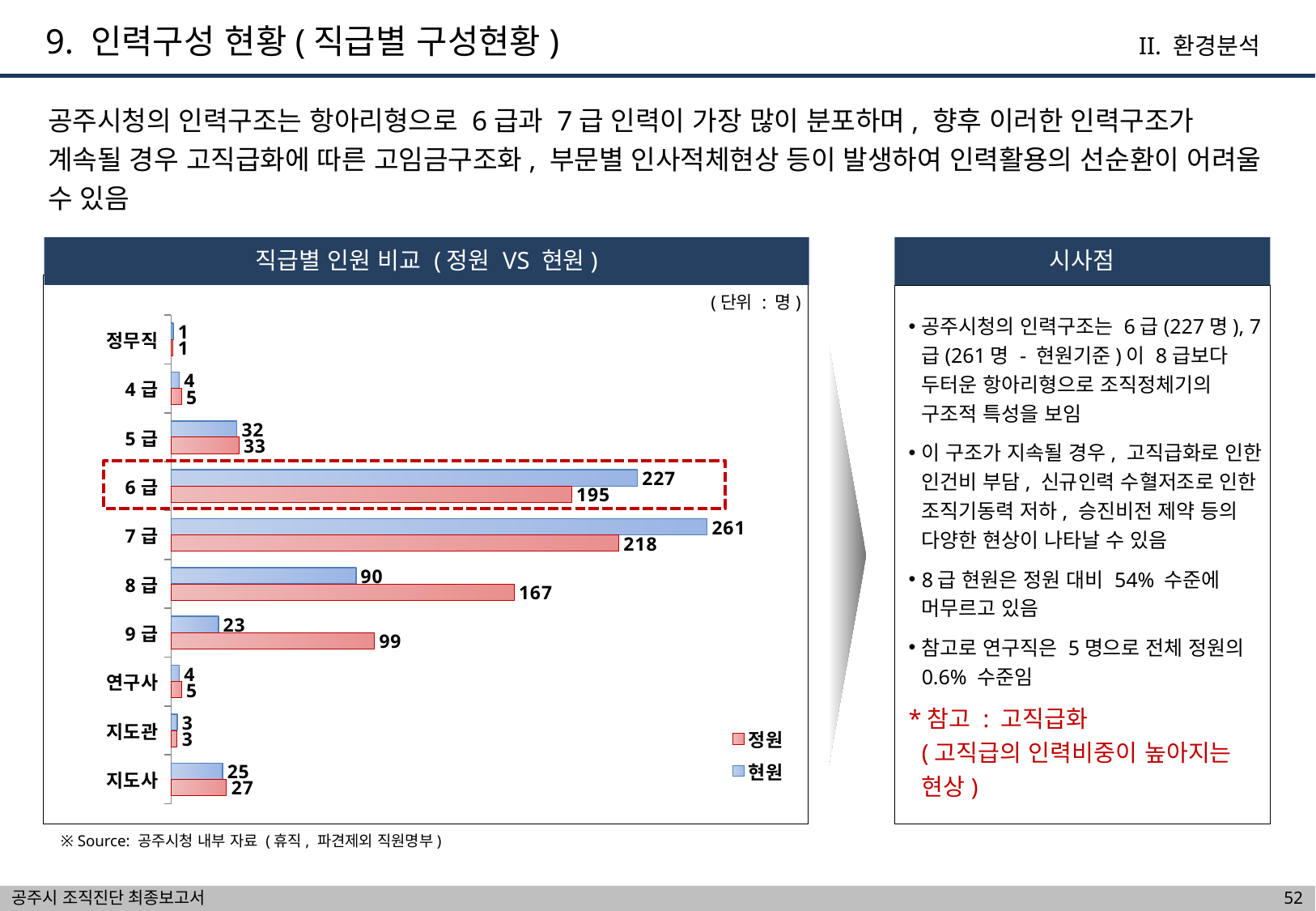
What is the 정원 value for 8급? 167 How many series does the legend list? 2 What is the difference between the 현원 and 정원 values for 6급? 32 Which category has the lowest 정원 value? 정무직 What kind of chart is shown on the slide? bar chart What is the difference between the 정원 and 현원 values for 8급? 77 What is the title of the chart? 직급별 인원 비교 (정원 VS 현원) How many categories are shown on the chart? 10 For 9급, which is larger, 정원 or 현원? 정원 What is the 현원 value for 7급? 261 What is the 현원 value for 9급? 23 Which category has the highest 현원 value? 7급